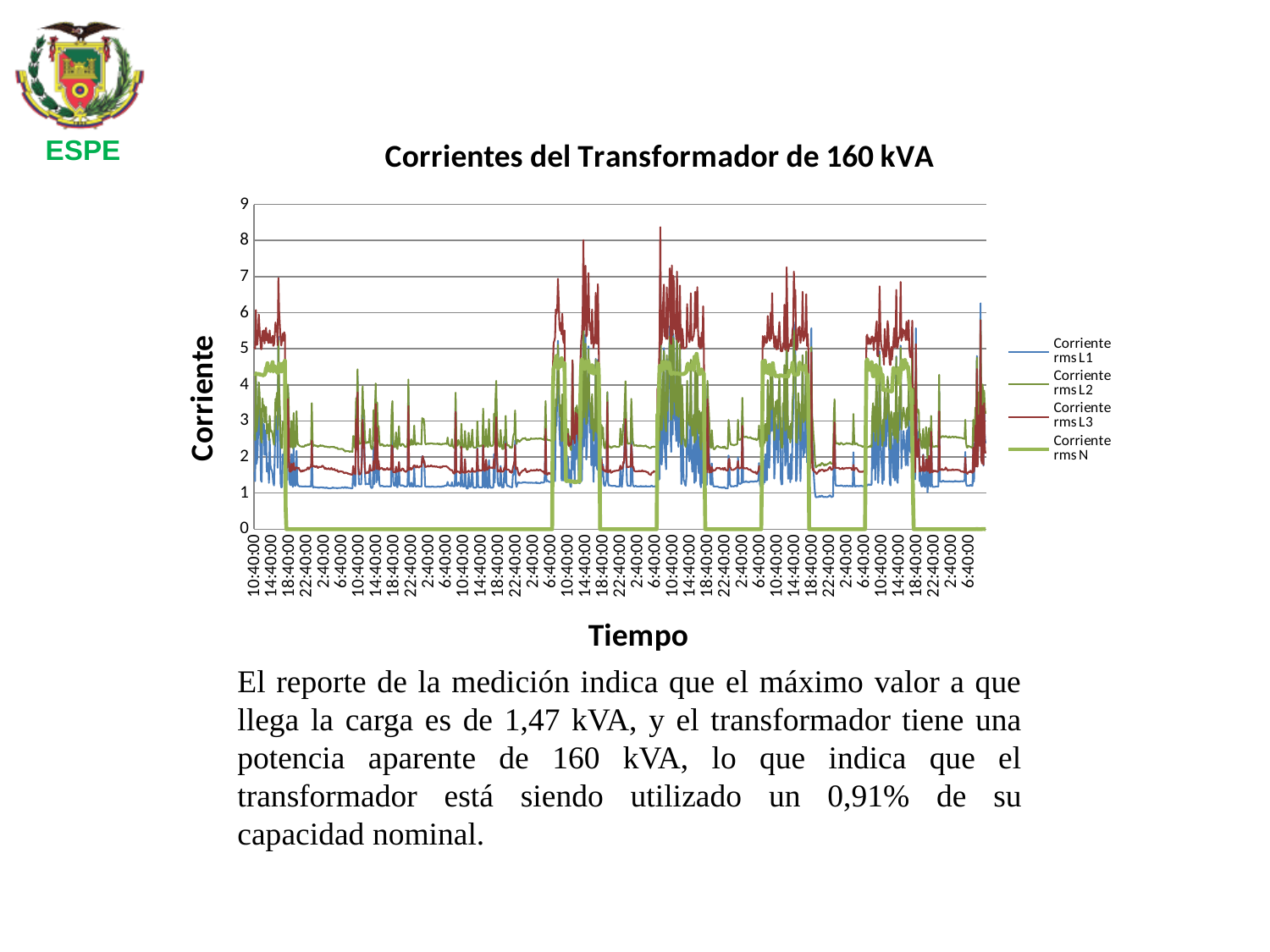
How many series does the chart's legend list? 4 Is the highest peak of Corriente rms N greater or less than 6? less Which series has the higher peak value, Corriente rms L3 or Corriente rms L2? Corriente rms L3 What is the label of the vertical axis of the chart? Corriente What kind of chart is shown on the slide? Line chart Is the highest peak of Corriente rms L1 greater or less than 7? less Is the highest peak of Corriente rms L3 greater or less than 8? greater Which series repeatedly drops to 0 in the chart? Corriente rms N Which series reaches the highest peak value in the chart? Corriente rms L3 What is the highest tick value shown on the vertical axis of the chart? 9 What is the title of the chart? Corrientes del Transformador de 160 kVA